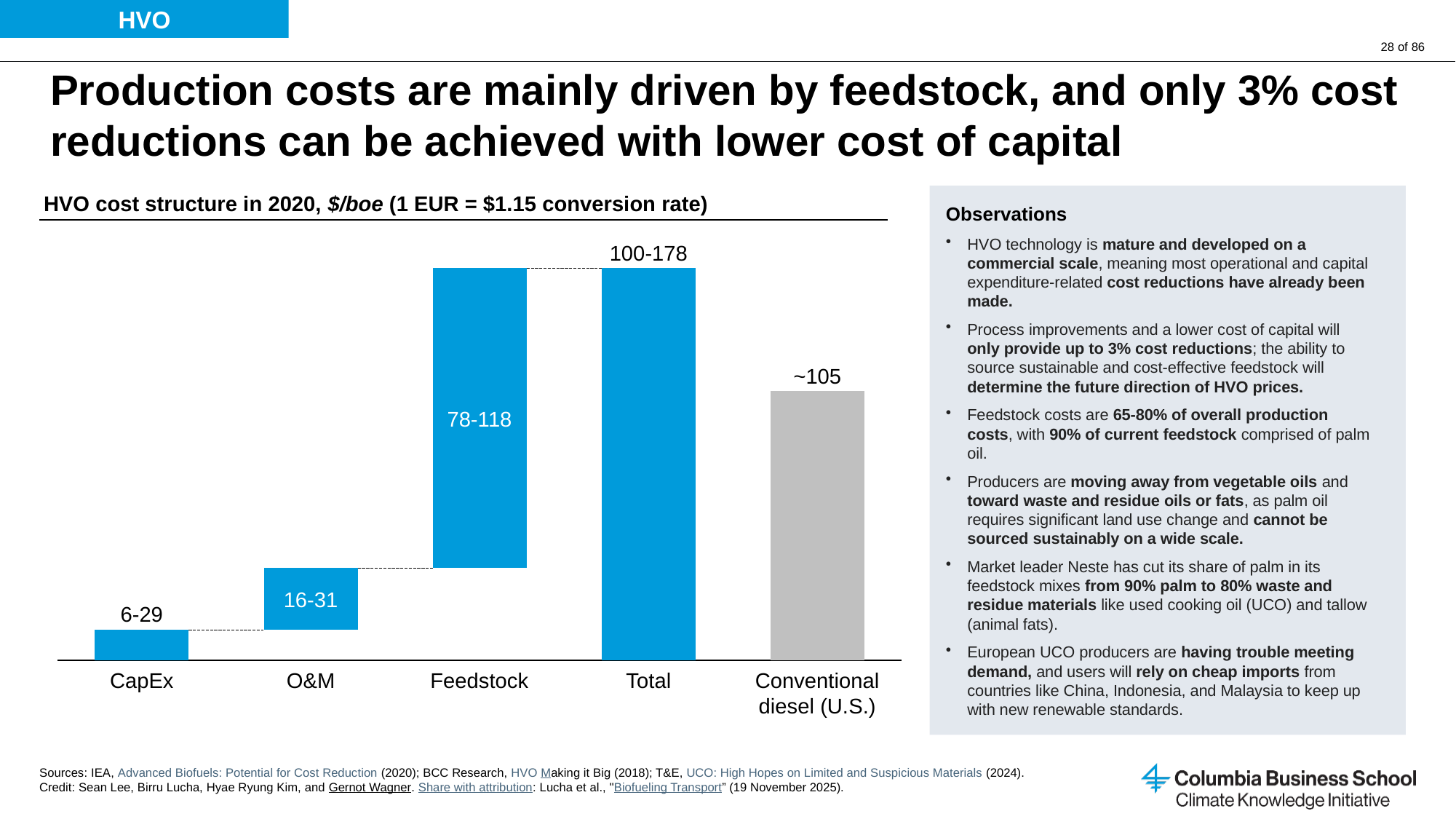
What is the title of the chart? HVO cost structure in 2020, $/boe (1 EUR = $1.15 conversion rate) How many categories are shown on the x axis of the chart? 5 Which bar in the chart is coloured grey rather than blue? Conventional diesel (U.S.) Which category has the tallest bar in the chart? Total What is the data label shown for the O&M bar? 16-31 Which cost component bar is taller, Feedstock or O&M? Feedstock What is the data label shown for the CapEx bar? 6-29 What is the data label shown for the Conventional diesel (U.S.) bar? ~105 What is the data label shown for the Feedstock bar? 78-118 What kind of chart is shown on the slide? Bar chart (waterfall) What is the data label shown for the Total bar? 100-178 Which category has the shortest bar in the chart? CapEx